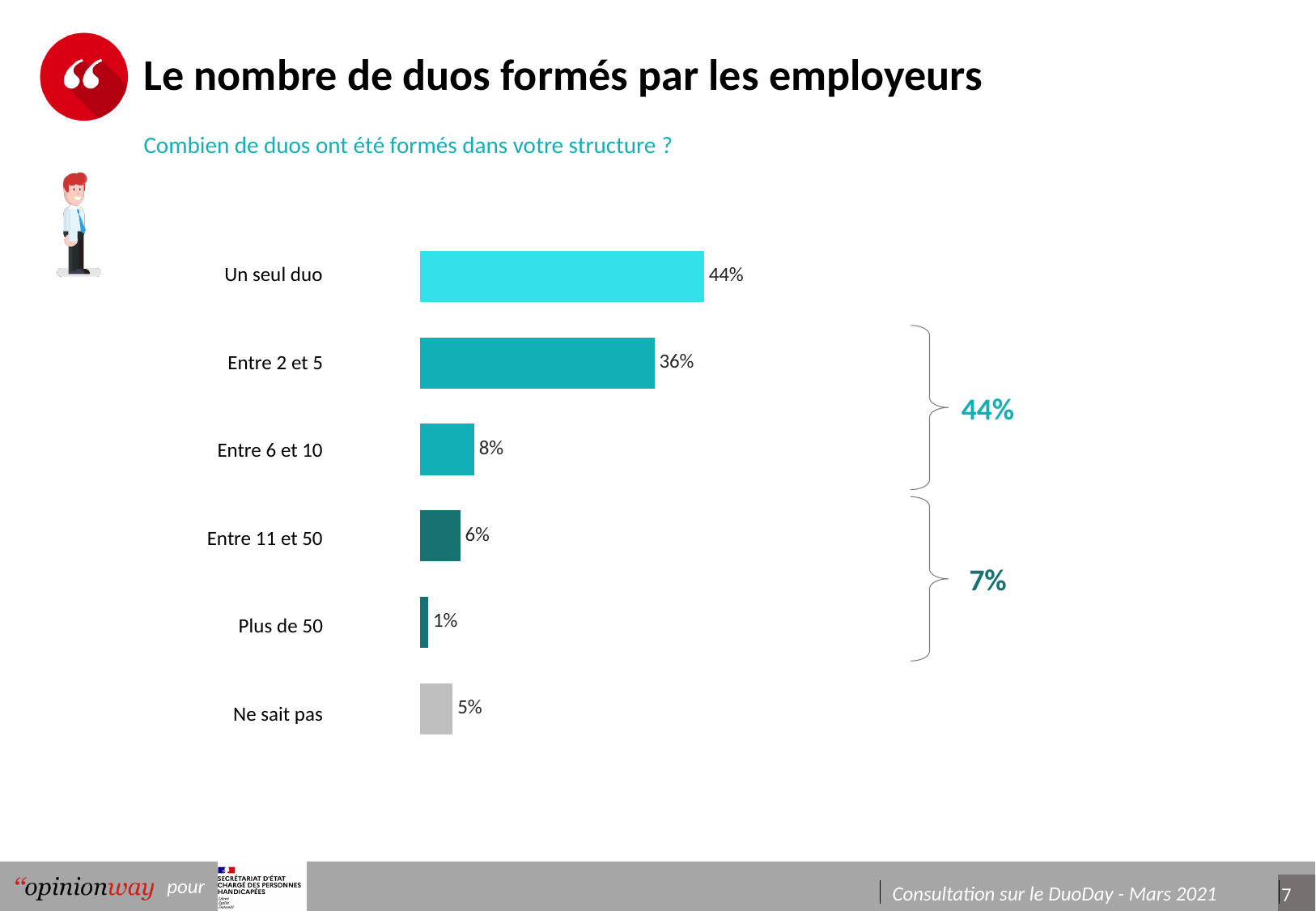
What is the value for "Entre 6 et 10"? 8% What is the value for "Plus de 50"? 1% Which is larger, "Entre 6 et 10" or "Entre 11 et 50"? Entre 6 et 10 What is the value for "Ne sait pas"? 5% Which category has the lowest value? Plus de 50 How many categories are shown in the chart? 6 What combined percentage is shown by the bracket grouping "Entre 11 et 50" and "Plus de 50"? 7% What percentage of respondents answered "Un seul duo"? 44% Which category has the highest value? Un seul duo What kind of chart is shown on the slide? Bar chart What is the difference between "Un seul duo" and "Entre 2 et 5"? 8% What is the value for "Entre 2 et 5"? 36%